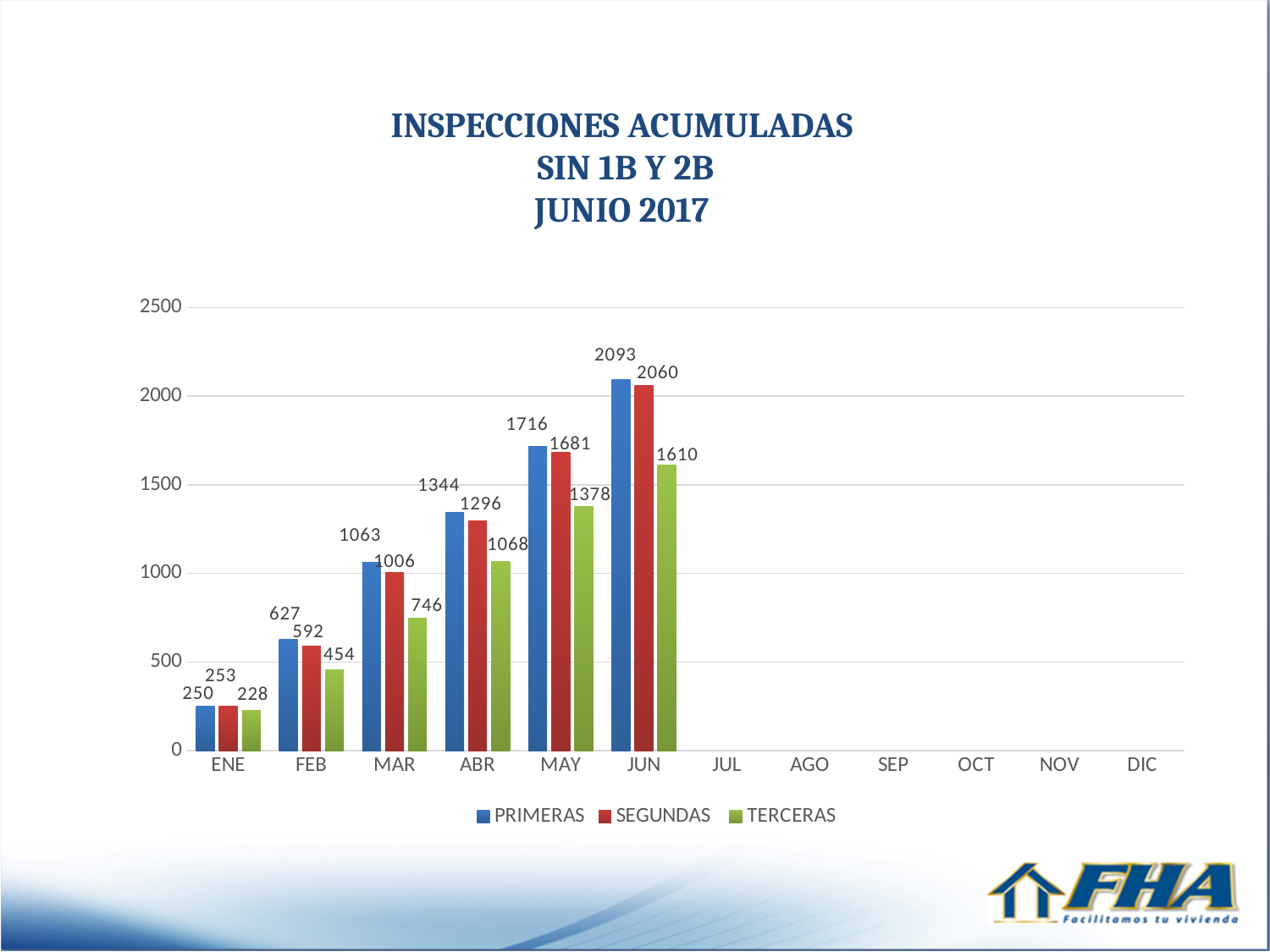
What is the value for TERCERAS in MAR? 746 What is the value for PRIMERAS in JUN? 2093 Which month has the highest value for TERCERAS? JUN Which is larger in FEB, SEGUNDAS or TERCERAS? SEGUNDAS What is the value for SEGUNDAS in ABR? 1296 How many series does the legend list? 3 Do the PRIMERAS values rise or fall from ENE to JUN? Rise What kind of chart is shown? Bar chart What colour represents TERCERAS in the legend? Green What is the difference between PRIMERAS and SEGUNDAS in MAY? 35 How many months have plotted bars? 6 Which month has the lowest value for PRIMERAS? ENE